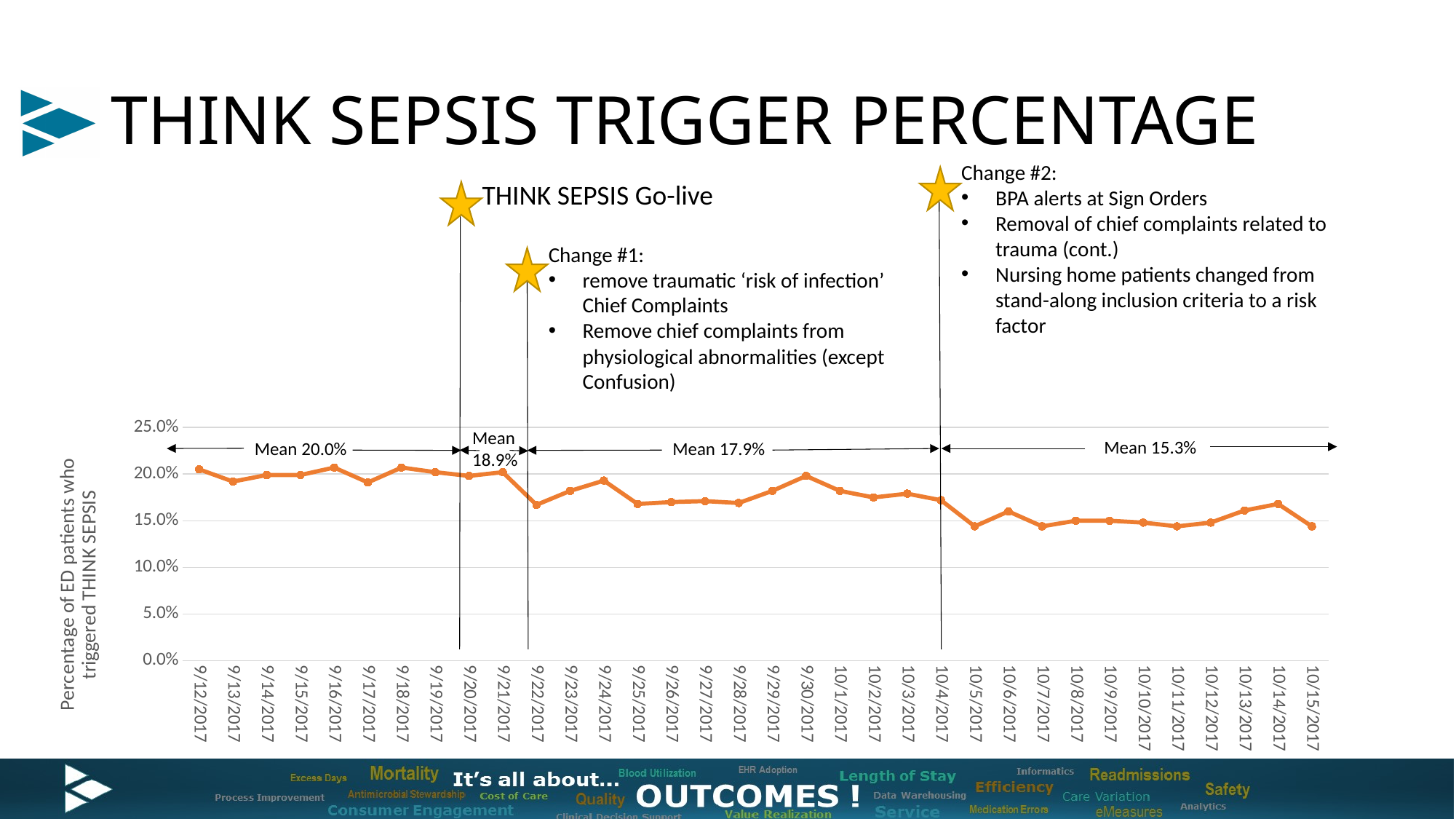
Is the value for 10/15/2017 greater or less than 15.0%? less Overall, do the values rise or fall from 9/12/2017 to 10/15/2017? fall Is the value for 9/30/2017 greater or less than 15.0%? greater What mean is annotated for the period before the THINK SEPSIS Go-live? Mean 20.0% What kind of chart is shown on the slide? line chart How many dates are plotted along the x axis of the chart? 34 What mean is annotated for the period after Change #2 (from 10/4/2017 onward)? Mean 15.3% Is the value for 10/5/2017 greater or less than 15.0%? less Which has the larger value, 9/12/2017 or 10/15/2017? 9/12/2017 Which has the larger value, 9/24/2017 or 9/25/2017? 9/24/2017